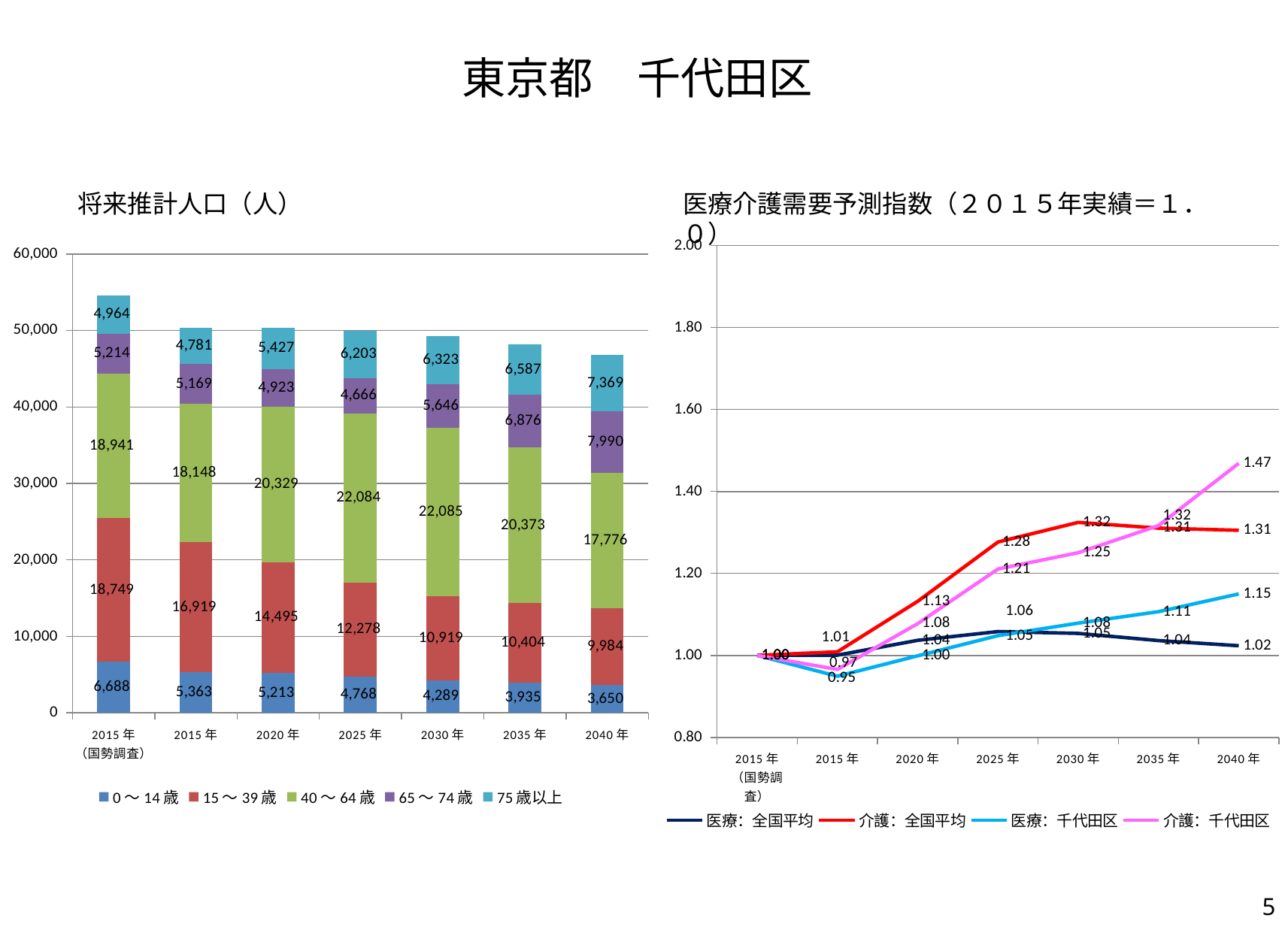
In the 医療介護需要予測指数 chart on the right, which is larger in 2040年: 介護：全国平均 or 医療：全国平均? 介護：全国平均 In the 将来推計人口（人） chart on the left, what is the value for 40～64歳 in 2030年? 22,085 In the 将来推計人口（人） chart on the left, how many year categories are shown on the x axis? 7 In the 将来推計人口（人） chart on the left, in which year is the 0～14歳 segment smallest? 2040年 In the 将来推計人口（人） chart on the left, what is the value for 75歳以上 in 2040年? 7,369 In the 医療介護需要予測指数 chart on the right, what is the value for 介護：千代田区 in 2040年? 1.47 What kind of chart is the 将来推計人口（人） chart on the left? Stacked bar chart In the 将来推計人口（人） chart on the left, what is the difference between the 15～39歳 value in 2015年（国勢調査） and in 2040年? 8,765 In the 医療介護需要予測指数 chart on the right, which series has the highest value in 2040年? 介護：千代田区 In the 医療介護需要予測指数 chart on the right, how many series does the legend list? 4 In the 将来推計人口（人） chart on the left, how many series does the legend list? 5 In the 将来推計人口（人） chart on the left, what is the total of the stacked bar for 2040年? 46,769